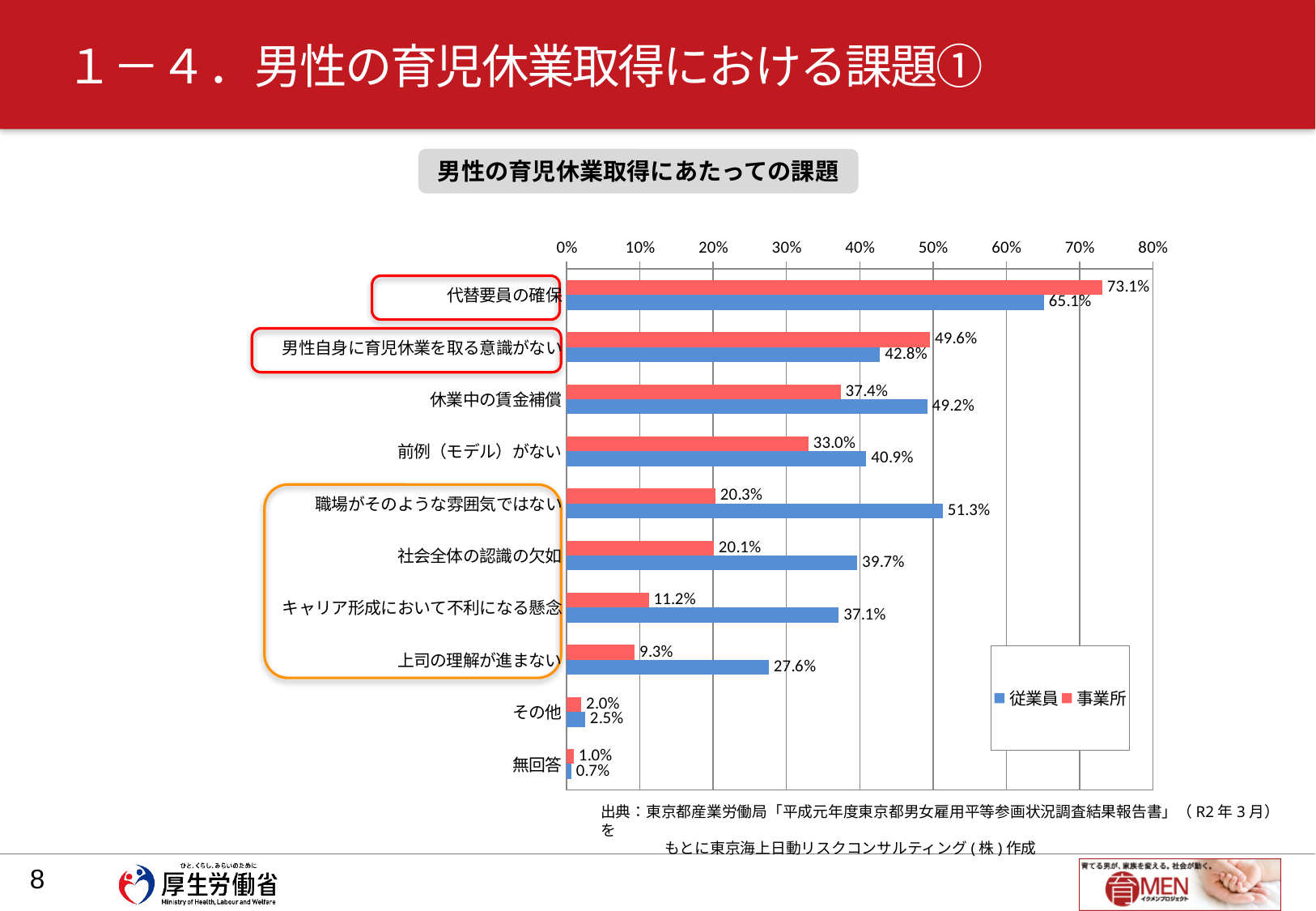
Which colour represents the 事業所 series? red Which category has the lowest 従業員 value? 無回答 For 休業中の賃金補償, which is larger: the 従業員 value or the 事業所 value? 従業員 What is the 従業員 value for 職場がそのような雰囲気ではない? 51.3% How many series does the legend list? 2 Which category has the highest 事業所 value? 代替要員の確保 Is the 事業所 value for キャリア形成において不利になる懸念 greater or less than 20%? less What is the 事業所 value for 代替要員の確保? 73.1% What type of chart is shown on the slide? bar chart What is the 従業員 value for 上司の理解が進まない? 27.6% How many categories are plotted on the chart? 10 What is the difference between the 従業員 and 事業所 values for 職場がそのような雰囲気ではない? 31.0%